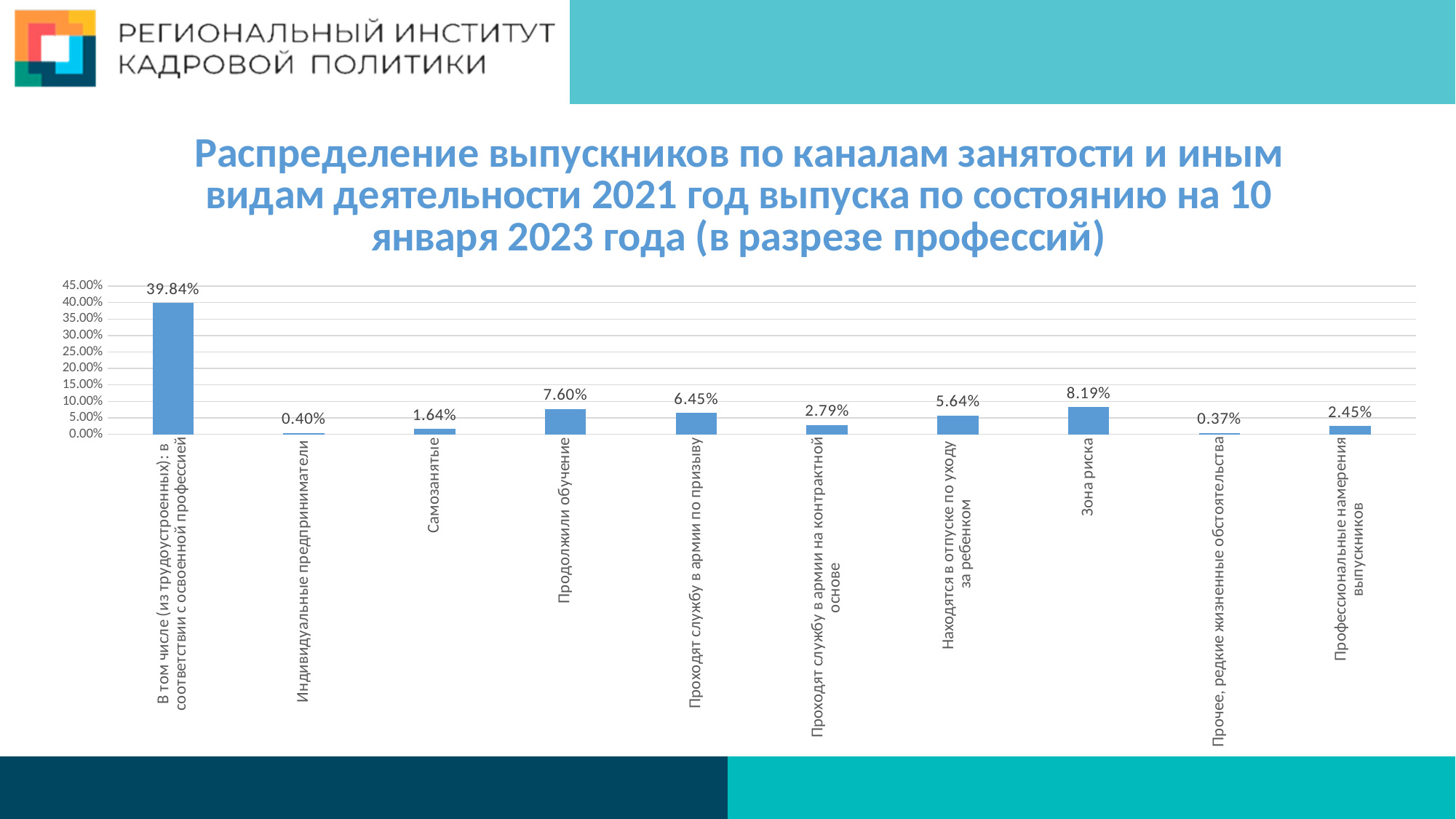
What is the value for Проходят службу в армии на контрактной основе? 2.79% What kind of chart is shown on the slide? bar chart What is the value for Самозанятые? 1.64% Which category has the highest value? В том числе (из трудоустроенных): в соответствии с освоенной профессией Is the value for В том числе (из трудоустроенных): в соответствии с освоенной профессией greater or less than 35.00%? greater What is the difference between the values for Зона риска and Продолжили обучение? 0.59% What is the value for Находятся в отпуске по уходу за ребенком? 5.64% How many categories are shown in the chart? 10 Which category has the lowest value? Прочее, редкие жизненные обстоятельства What is the value for Зона риска? 8.19% Which is larger: the value for Проходят службу в армии по призыву or the value for Находятся в отпуске по уходу за ребенком? Проходят службу в армии по призыву What is the value for Продолжили обучение? 7.60%